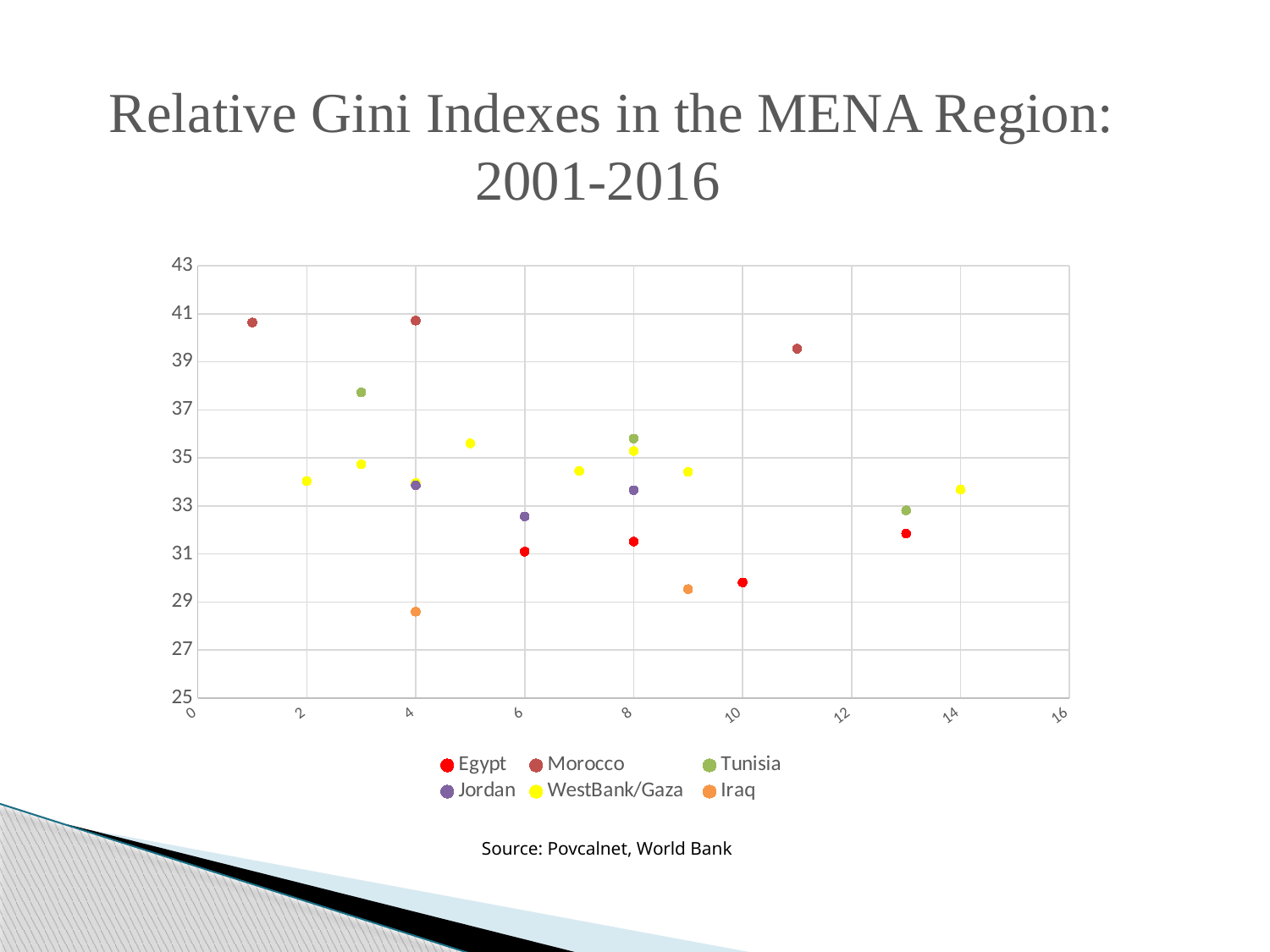
Which series has the lowest plotted point on the chart? Iraq Is the Iraq value at x = 4 greater or less than 29? less How many points are plotted for WestBank/Gaza? 8 At x = 8, which is higher, the Tunisia point or the Egypt point? Tunisia Do the Tunisia points rise or fall as x increases? fall How many series does the legend list? 6 What source is cited below the chart? Povcalnet, World Bank Is the Morocco value at x = 11 greater or less than 39? greater Which series has the highest plotted point on the chart? Morocco What kind of chart is shown on the slide? Scatter chart Is the Tunisia value at x = 3 greater or less than 37? greater How many points are plotted for Egypt? 4